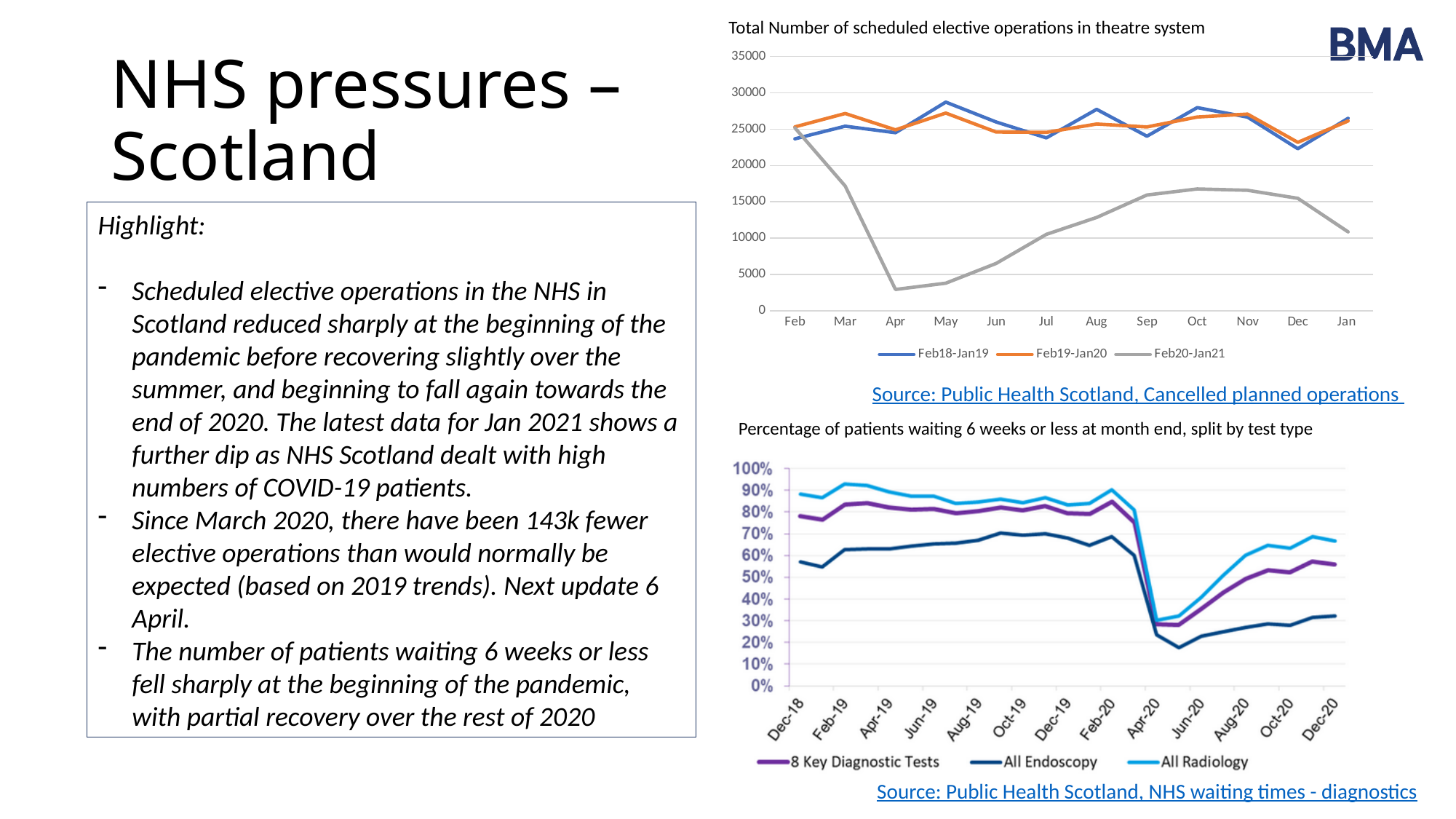
In the 'Total Number of scheduled elective operations in theatre system' chart, does the Feb20-Jan21 series rise or fall between Apr and Oct? rise In the 'Percentage of patients waiting 6 weeks or less at month end' chart, which series has the lowest value in Apr-20? All Endoscopy How many months are shown on the x axis of the 'Total Number of scheduled elective operations in theatre system' chart? 12 What type of chart is the 'Total Number of scheduled elective operations in theatre system' chart? line chart How many series does the legend of the 'Total Number of scheduled elective operations in theatre system' chart list? 3 In the 'Total Number of scheduled elective operations in theatre system' chart, is the Feb20-Jan21 value for Apr greater or less than 5000? less In the 'Total Number of scheduled elective operations in theatre system' chart, is the Feb20-Jan21 value for Jan greater or less than 15000? less How many series does the legend of the 'Percentage of patients waiting 6 weeks or less at month end, split by test type' chart list? 3 In the 'Total Number of scheduled elective operations in theatre system' chart, in which month does the Feb20-Jan21 series reach its lowest value? Apr In the 'Percentage of patients waiting 6 weeks or less at month end' chart, is the All Radiology value for Dec-20 greater or less than 60%? greater In the 'Percentage of patients waiting 6 weeks or less at month end' chart, which series has the higher value in Feb-19: All Radiology or All Endoscopy? All Radiology In the 'Total Number of scheduled elective operations in theatre system' chart, which series has the higher value in Jul: Feb19-Jan20 or Feb20-Jan21? Feb19-Jan20